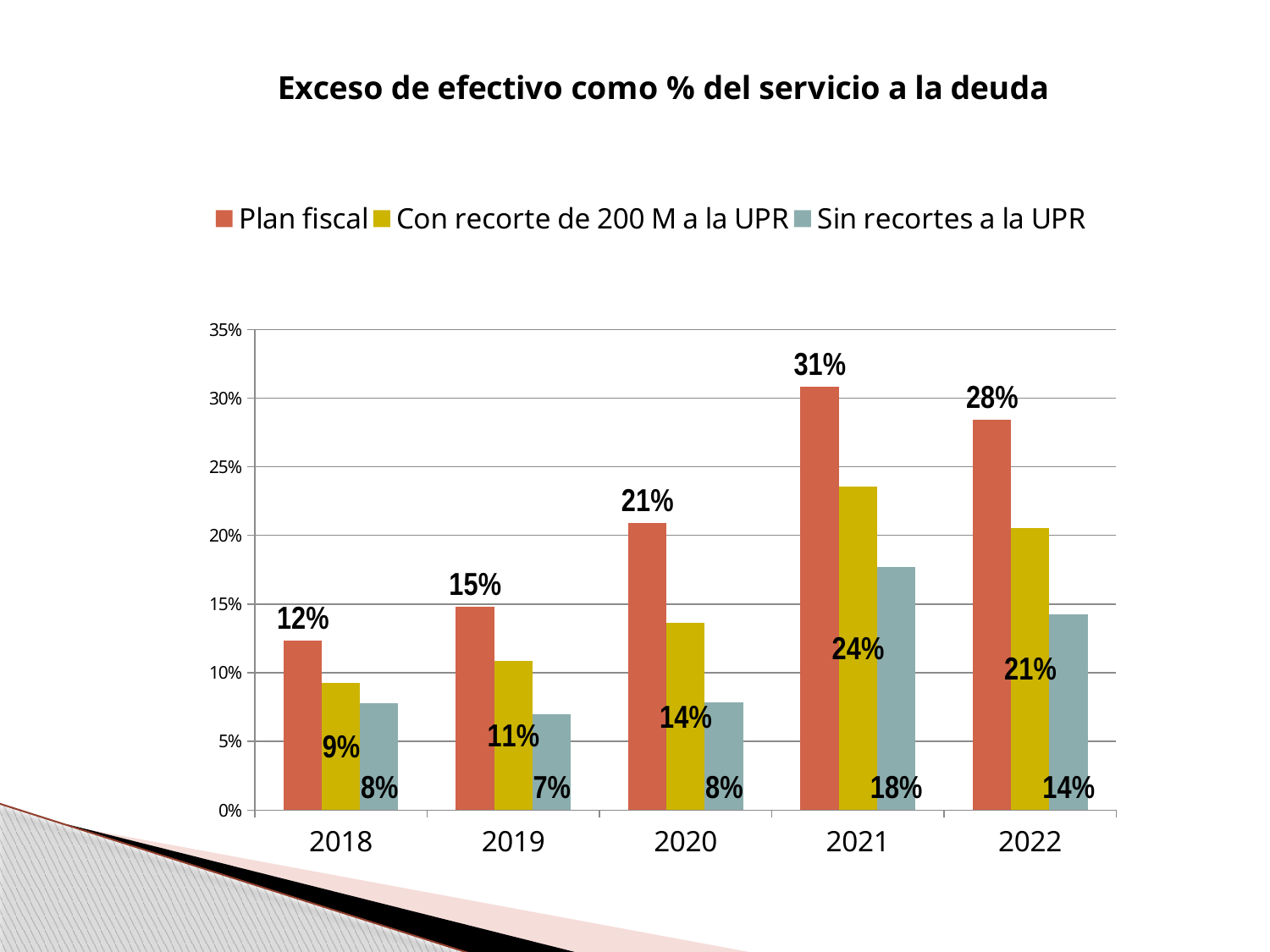
Is the Con recorte de 200 M a la UPR value in 2021 greater or less than 20%? greater How many series does the legend list? 3 In which year is the Sin recortes a la UPR value lowest? 2019 What kind of chart is shown on the slide? Bar chart What is the value for Sin recortes a la UPR in 2019? 7% What is the difference between the Plan fiscal value and the Sin recortes a la UPR value in 2022? 14% What is the value for Plan fiscal in 2021? 31% How many years are shown on the x axis? 5 Which is larger in 2018: the Plan fiscal value or the Con recorte de 200 M a la UPR value? Plan fiscal What is the title of the chart? Exceso de efectivo como % del servicio a la deuda What is the value for Con recorte de 200 M a la UPR in 2020? 14% In which year is the Plan fiscal value highest? 2021